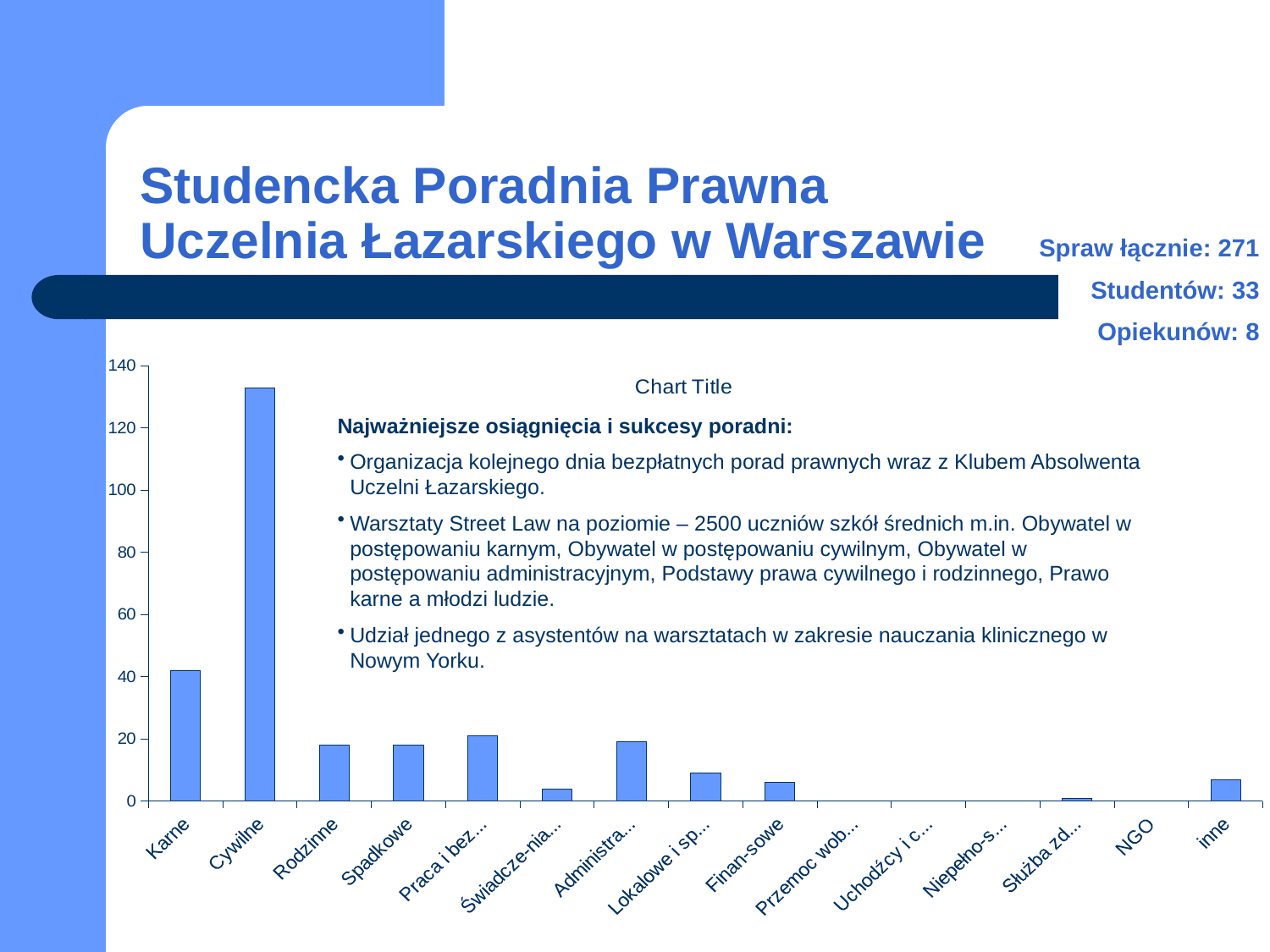
Is the value for Karne greater or less than 20? greater Is the value for Rodzinne greater or less than 40? less Which category has the highest bar in the chart? Cywilne Is the value for Karne greater or less than 60? less Which is larger, the value for Lokalowe i sp... or the value for Świadcze-nia...? Lokalowe i sp... Which is larger, the value for Cywilne or the value for Karne? Cywilne What is the title shown on the chart? Chart Title Which is larger, the value for Karne or the value for Rodzinne? Karne How many categories are shown on the x axis of the chart? 15 What kind of chart is shown on the slide? bar chart